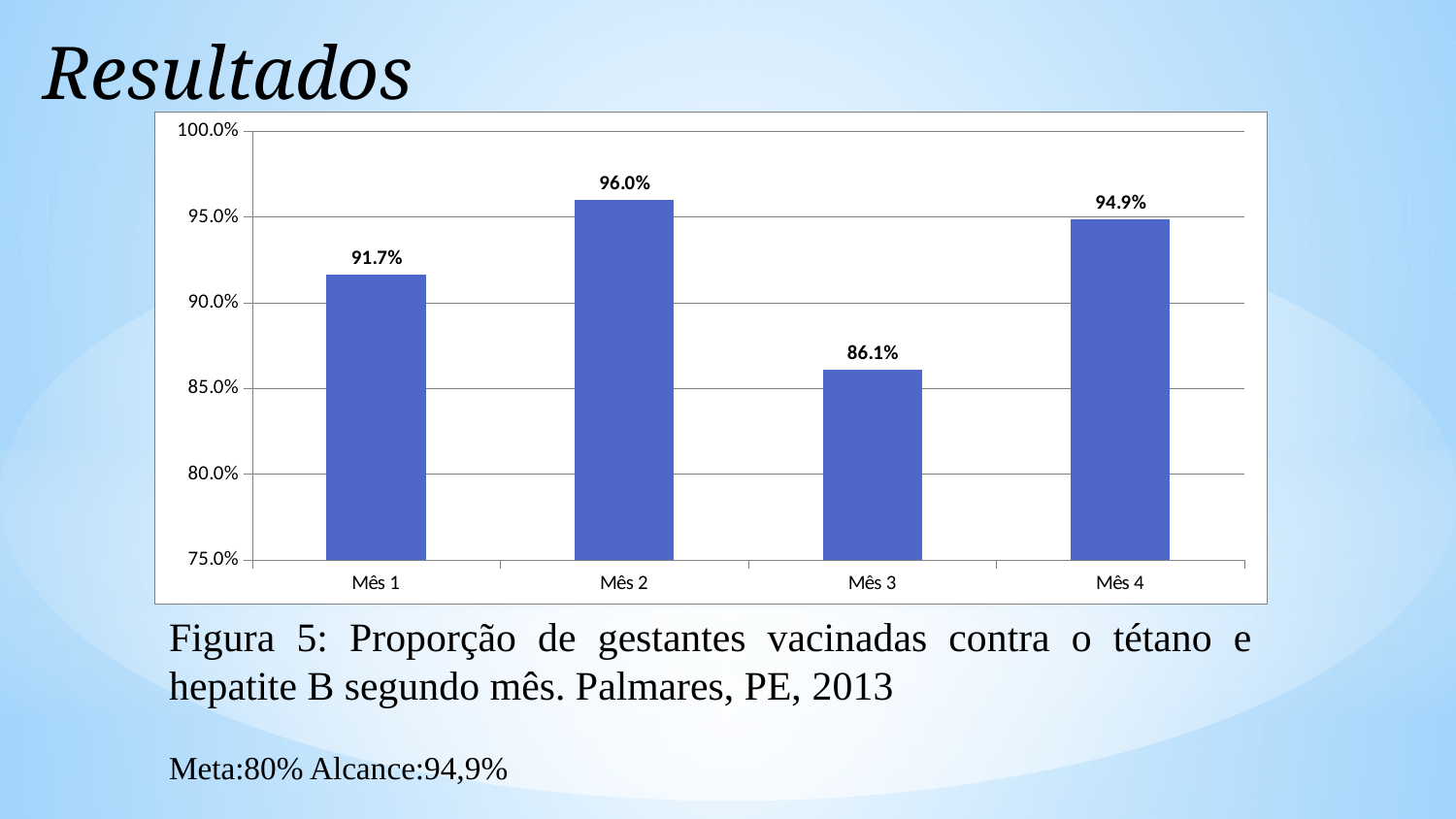
What is the difference between the values for Mês 2 and Mês 3? 9.9% Which is larger, the value for Mês 1 or the value for Mês 4? Mês 4 Which month has the highest value? Mês 2 What is the value for Mês 3? 86.1% Is the value for Mês 3 greater or less than 90.0%? less Which month has the lowest value? Mês 3 How many months are shown on the x axis? 4 What kind of chart is shown on the slide? bar chart What is the difference between the values for Mês 4 and Mês 1? 3.2% Does the value rise or fall from Mês 2 to Mês 3? fall What is the value for Mês 1? 91.7% What is the value for Mês 4? 94.9%